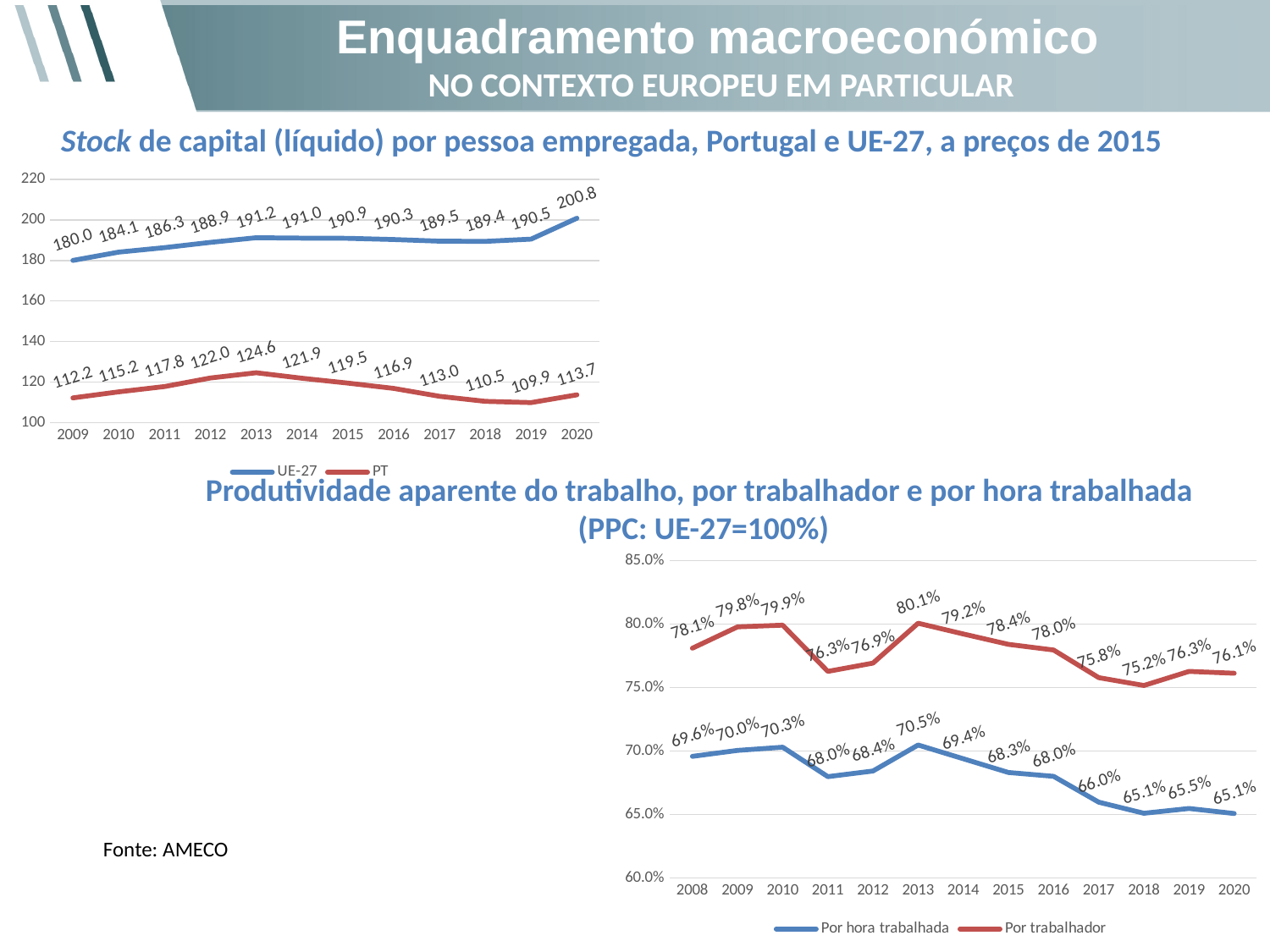
In the 'Produtividade aparente do trabalho' chart, what is the value for 'Por trabalhador' in 2013? 80.1% In the 'Stock de capital (líquido) por pessoa empregada' chart, what is the value for PT in 2013? 124.6 In the 'Stock de capital (líquido) por pessoa empregada' chart, in which year is the PT series lowest? 2019 In the 'Produtividade aparente do trabalho' chart, in which year is the 'Por hora trabalhada' series highest? 2013 In the 'Stock de capital (líquido) por pessoa empregada' chart, how many years are shown on the x axis? 12 In the 'Produtividade aparente do trabalho' chart, what is the value for 'Por hora trabalhada' in 2018? 65.1% What kind of chart is the 'Stock de capital (líquido) por pessoa empregada' chart? Line chart In the 'Stock de capital (líquido) por pessoa empregada' chart, how many series does the legend list? 2 In the 'Stock de capital (líquido) por pessoa empregada' chart, what is the difference between UE-27 and PT in 2009? 67.8 In the 'Produtividade aparente do trabalho' chart, what is the difference between 'Por trabalhador' and 'Por hora trabalhada' in 2008? 8.5% In the 'Stock de capital (líquido) por pessoa empregada' chart, what is the value for UE-27 in 2020? 200.8 In the 'Produtividade aparente do trabalho' chart, which series is higher in 2020, 'Por hora trabalhada' or 'Por trabalhador'? Por trabalhador